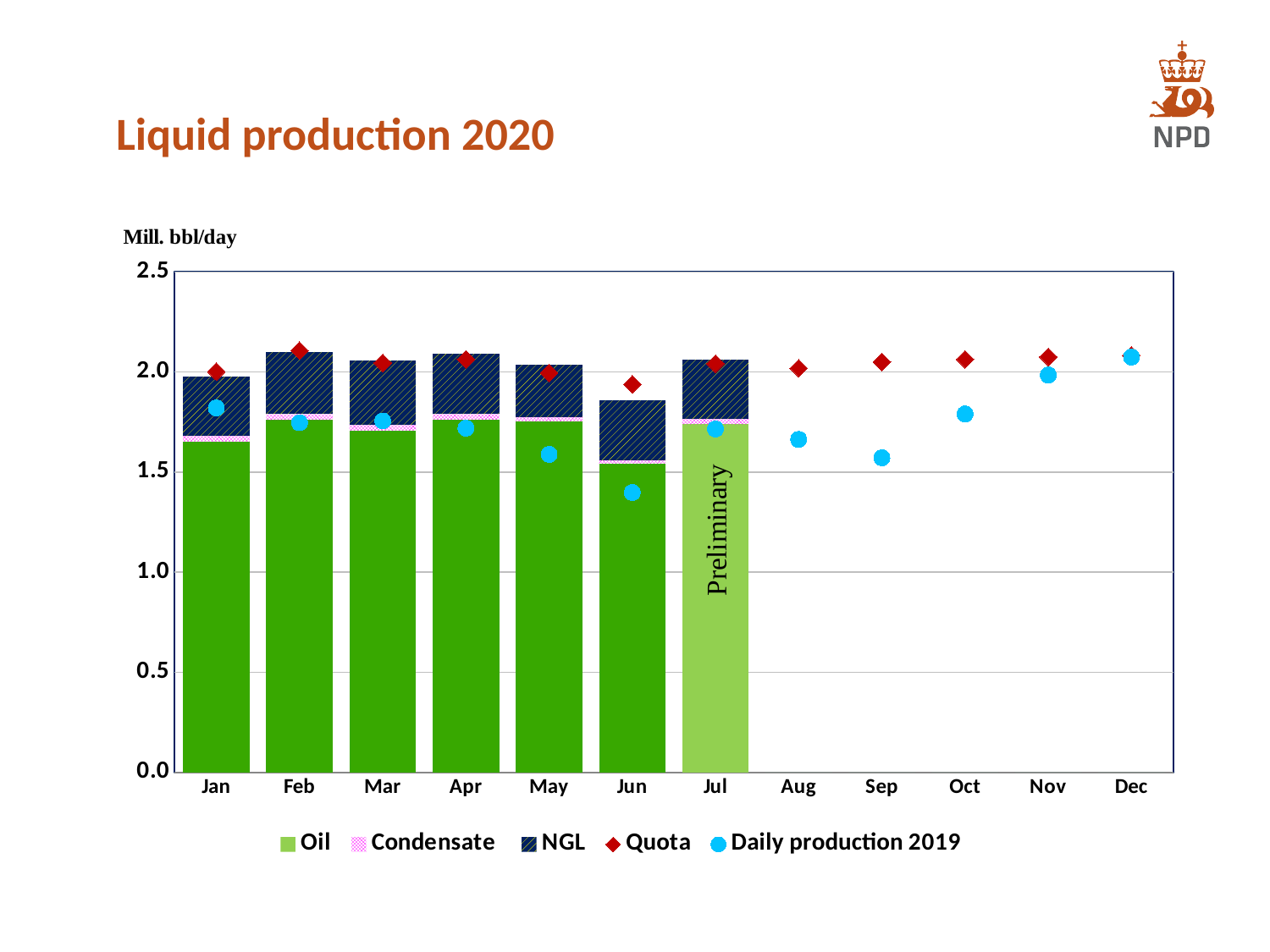
Is the Daily production 2019 value for Jun greater or less than 1.5? less What unit is shown above the y axis? Mill. bbl/day Which month has the tallest stacked production bar? Feb Which month has the lowest Quota value? Jun How many series does the legend list? 5 Is the Quota value for Feb greater or less than 2.0? greater For how many months are stacked production bars plotted? 7 How many months are shown on the x axis? 12 Is the total stacked bar for Jun greater or less than 2.0? less Which month has the shortest stacked production bar? Jun What kind of chart is shown on the slide? Stacked bar chart with point markers Which month has the lowest Daily production 2019 value? Jun